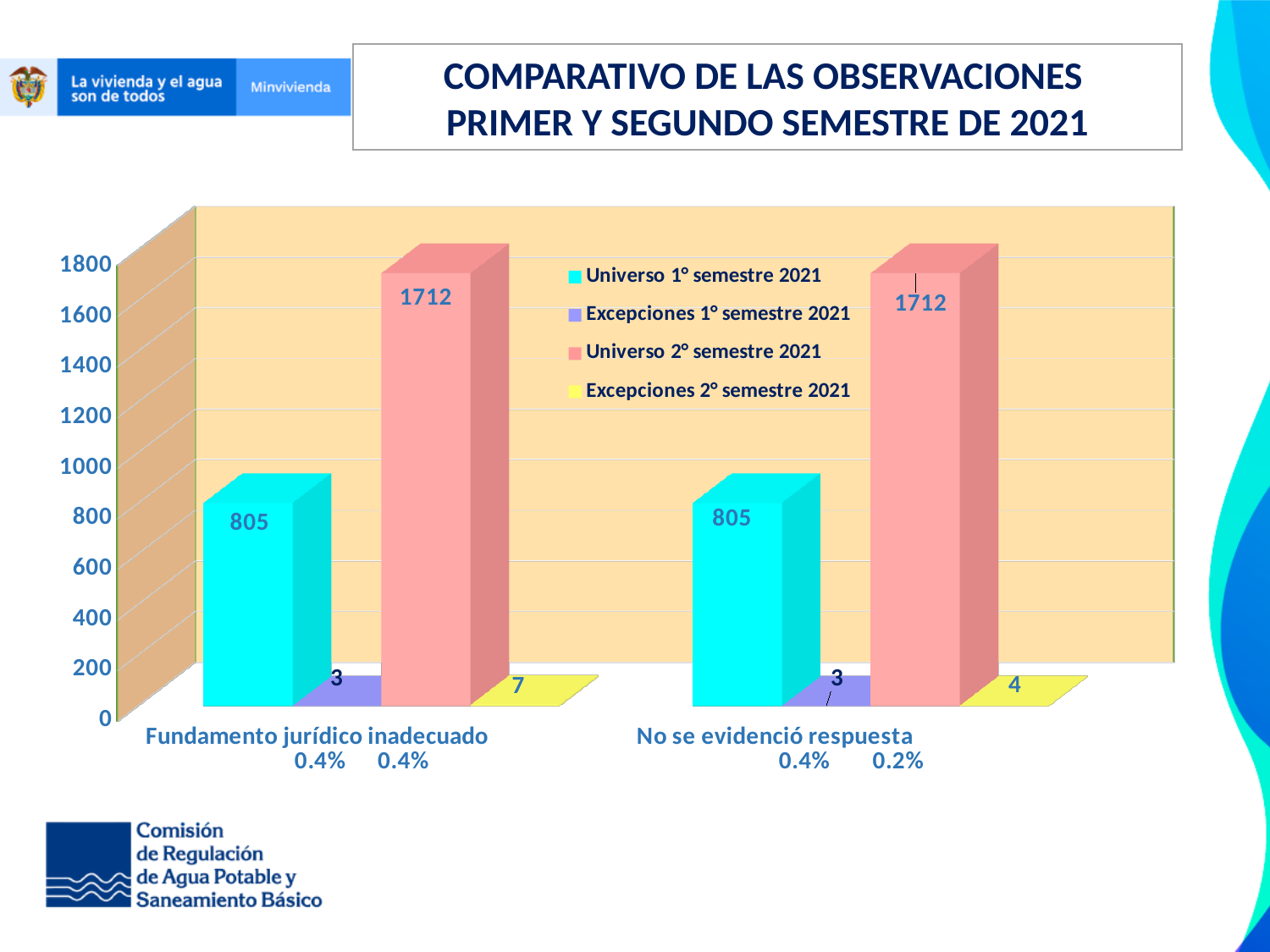
What is the difference between Universo 2° semestre 2021 and Universo 1° semestre 2021 for No se evidenció respuesta? 907 Which is larger for Fundamento jurídico inadecuado: Excepciones 1° semestre 2021 or Excepciones 2° semestre 2021? Excepciones 2° semestre 2021 What is the value of Excepciones 2° semestre 2021 for No se evidenció respuesta? 4 What is the value of Excepciones 1° semestre 2021 for No se evidenció respuesta? 3 How many categories are shown on the x axis? 2 What is the value of Universo 1° semestre 2021 for No se evidenció respuesta? 805 What is the title of the chart on the slide? COMPARATIVO DE LAS OBSERVACIONES PRIMER Y SEGUNDO SEMESTRE DE 2021 Which series has the highest value for Fundamento jurídico inadecuado? Universo 2° semestre 2021 What is the value of Universo 2° semestre 2021 for Fundamento jurídico inadecuado? 1712 What is the value of Excepciones 2° semestre 2021 for Fundamento jurídico inadecuado? 7 How many series does the legend list? 4 What kind of chart is shown on the slide? bar chart